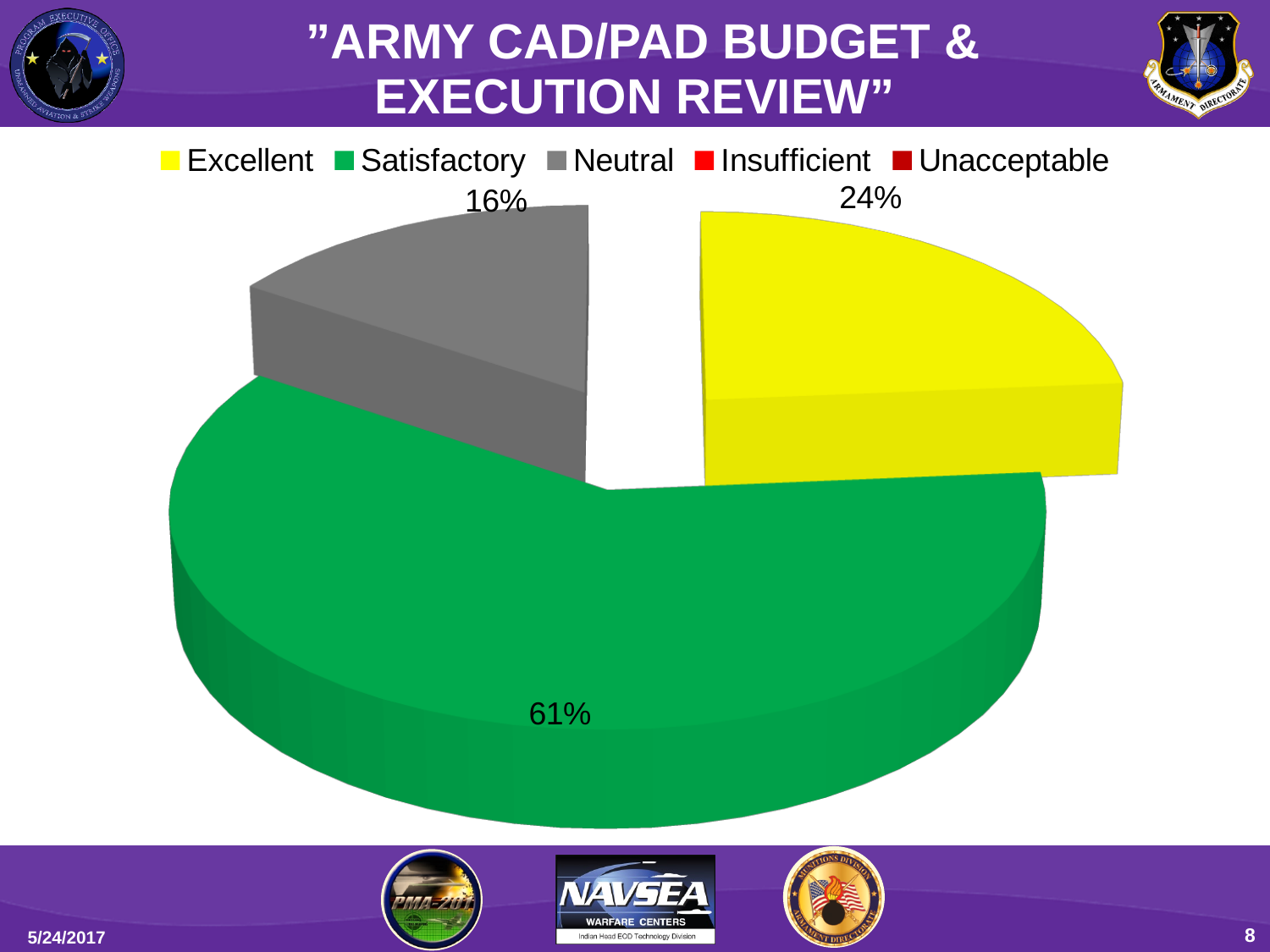
Which of the visible slices, Excellent or Neutral, is smaller? Neutral What is the difference in percentage points between the Satisfactory slice and the Excellent slice? 37 What percentage of the pie is labelled Satisfactory? 61% What percentage of the pie is labelled Neutral? 16% What is the difference in percentage points between the Excellent slice and the Neutral slice? 8 Which category has the largest share of the pie? Satisfactory What percentage of the pie is labelled Excellent? 24% How many slices are visible in the pie? 3 What kind of chart is shown on the slide? pie chart How many categories does the legend list? 5 What colour is the Satisfactory slice? green Which is larger, the Excellent slice or the Neutral slice? Excellent